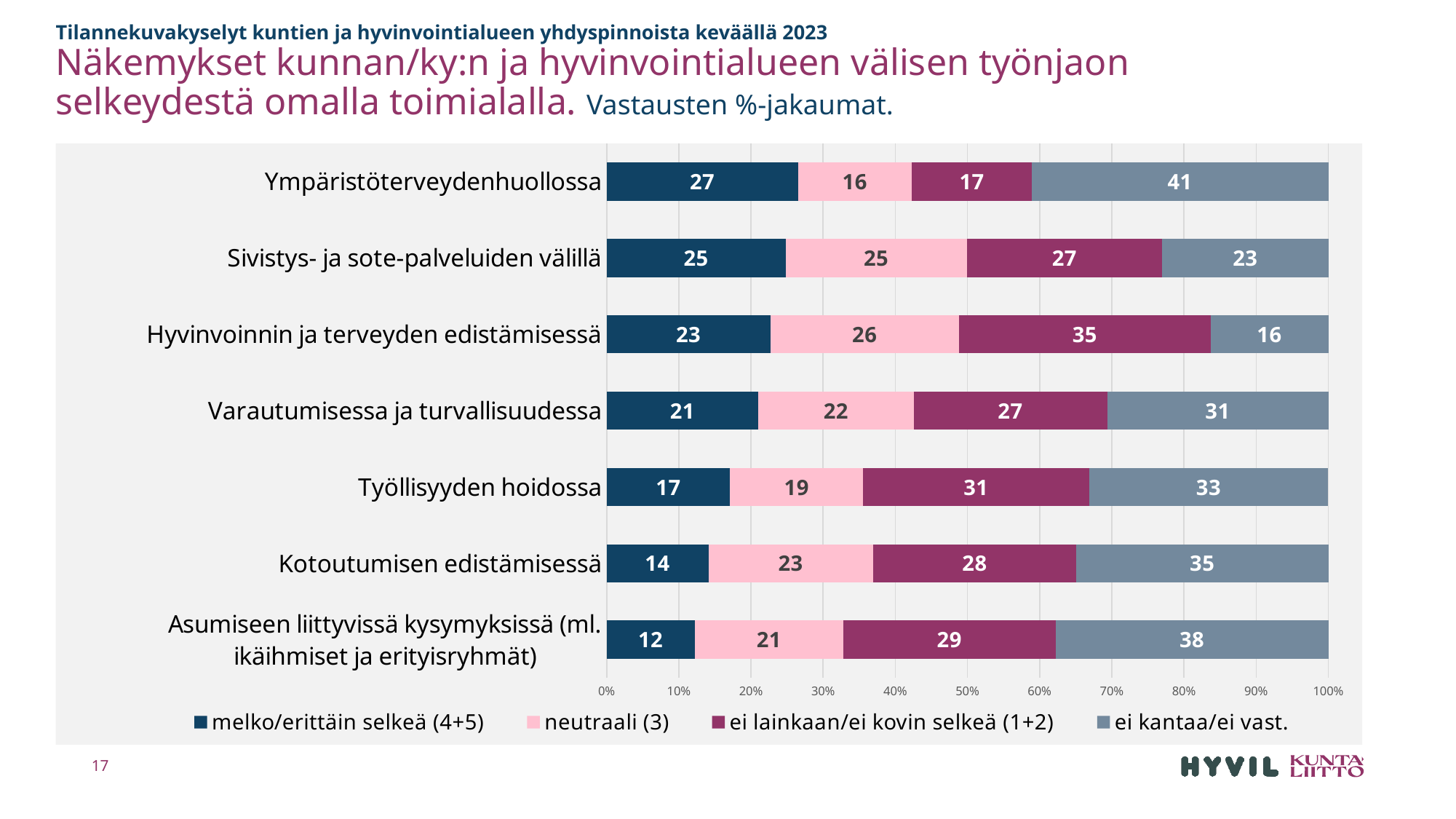
Which is larger: the "ei lainkaan/ei kovin selkeä (1+2)" value for Työllisyyden hoidossa or for Varautumisessa ja turvallisuudessa? Työllisyyden hoidossa What is the value of "ei kantaa/ei vast." for Kotoutumisen edistämisessä? 35 What is the difference between the "ei kantaa/ei vast." values for Ympäristöterveydenhuollossa and Hyvinvoinnin ja terveyden edistämisessä? 25 What is the value of "neutraali (3)" for Työllisyyden hoidossa? 19 How many categories are shown on the chart? 7 What is the value of "ei lainkaan/ei kovin selkeä (1+2)" for Hyvinvoinnin ja terveyden edistämisessä? 35 What kind of chart is shown on the slide? Stacked bar chart Which series is shown in pink in the legend? neutraali (3) Which category has the highest value for "melko/erittäin selkeä (4+5)"? Ympäristöterveydenhuollossa How many series does the legend list? 4 Which category has the lowest value for "melko/erittäin selkeä (4+5)"? Asumiseen liittyvissä kysymyksissä (ml. ikäihmiset ja erityisryhmät) What is the value of "melko/erittäin selkeä (4+5)" for Ympäristöterveydenhuollossa? 27